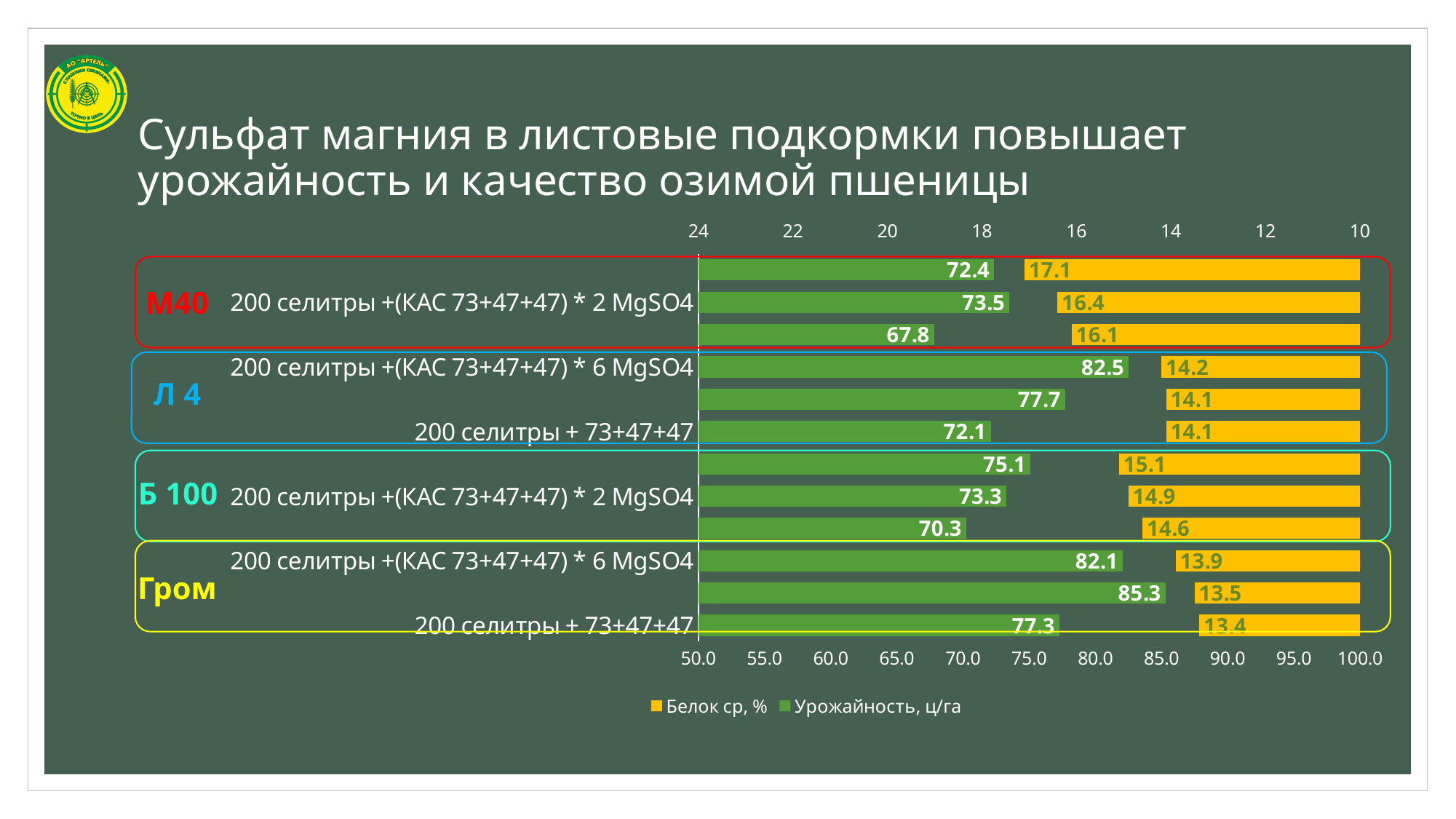
How many variety groups (М40, Л 4, Б 100, Гром) are shown on the chart? 4 What is the highest Белок ср, % value on the chart? 17.1 How many series does the legend list? 2 What is the lowest Урожайность, ц/га value on the chart? 67.8 In the Л 4 group, what is the Урожайность, ц/га value for the bar labelled '200 селитры + 73+47+47'? 72.1 What kind of chart is shown on the slide? bar chart How many green Урожайность bars are plotted in total? 12 What are the two series named in the legend? Белок ср, % and Урожайность, ц/га In the Л 4 group, what is the Белок ср, % value for the bar labelled '200 селитры +(КАС 73+47+47) * 6 MgSO4'? 14.2 In the Гром group, what is the difference between the highest Урожайность value (85.3) and the lowest (77.3)? 8.0 What is the highest Урожайность, ц/га value on the chart? 85.3 What is the lowest Белок ср, % value on the chart? 13.4